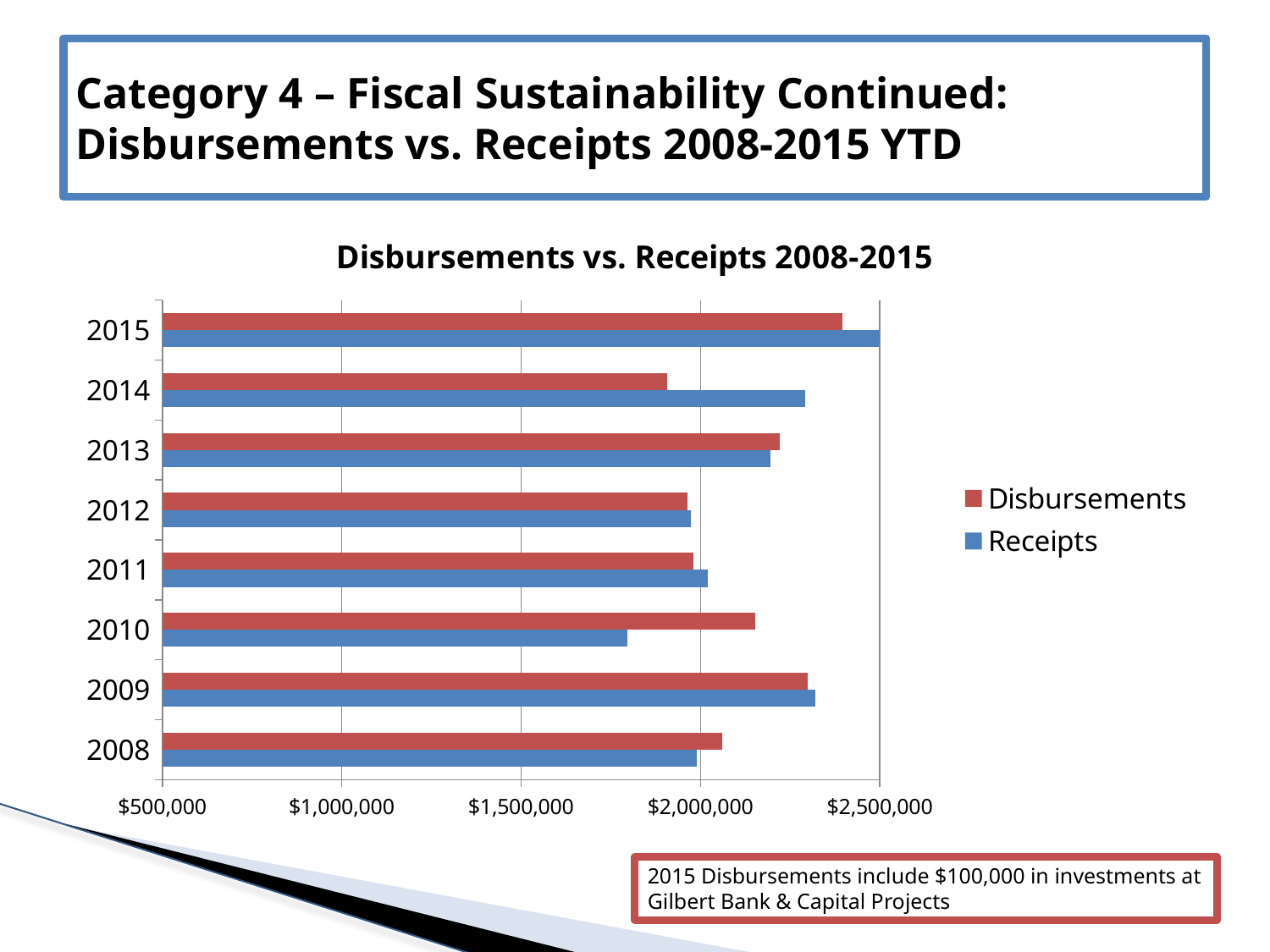
Which year has the lowest Receipts? 2010 What kind of chart is shown on the slide? Bar chart How many series does the legend list? 2 How many years are shown on the chart? 8 What is the title of the chart? Disbursements vs. Receipts 2008-2015 Which year has the highest Receipts? 2015 In 2010, which is larger, Disbursements or Receipts? Disbursements Is the value for Receipts in 2010 greater or less than $2,000,000? less Which year has the lowest Disbursements? 2014 In 2014, which is larger, Disbursements or Receipts? Receipts Is the value for Disbursements in 2013 greater or less than $2,000,000? greater Is the value for Disbursements in 2014 greater or less than $2,000,000? less